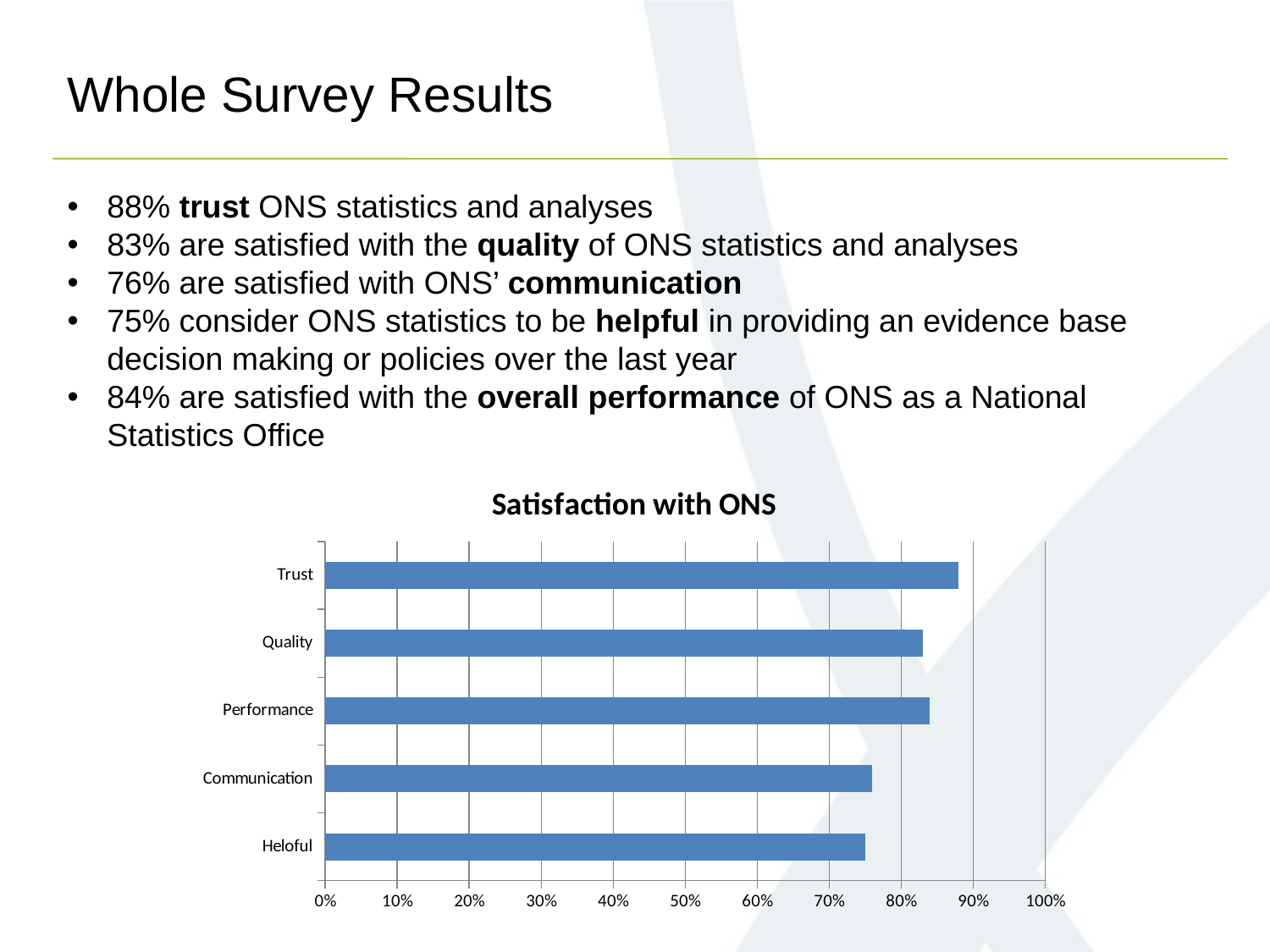
What is the maximum value shown on the horizontal axis of the chart? 100% Is the value for Trust greater or less than 80%? greater Which is larger, the value for Trust or the value for Quality? Trust What is the title of the chart? Satisfaction with ONS Is the value for Quality greater or less than 90%? less What type of chart is shown on the slide? bar chart Is the value for Heloful greater or less than 70%? greater Which is larger, the value for Communication or the value for Trust? Trust According to the slide, what percentage trust ONS statistics and analyses, as plotted for Trust? 88% Which category has the highest value in the chart? Trust How many categories are plotted in the chart? 5